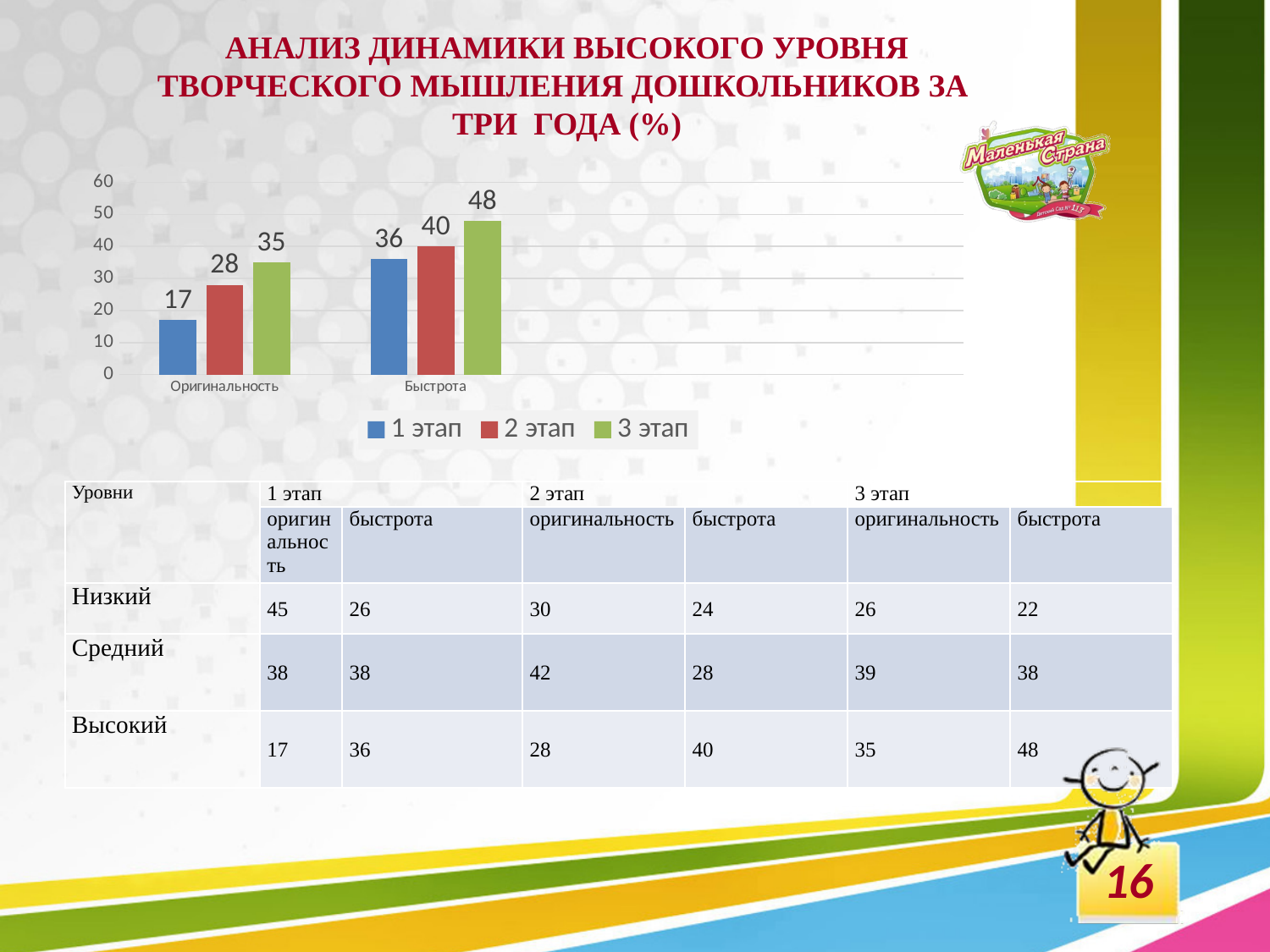
What colour are the bars for 3 этап? green What kind of chart is shown on the slide? bar chart Do the values for Быстрота rise or fall from 1 этап to 3 этап? rise How many categories are shown on the x axis? 2 How many series does the legend list? 3 What is the difference between the 3 этап and 1 этап values for Оригинальность? 18 Which series has the lowest value in the Оригинальность category? 1 этап Which is larger: the 2 этап value for Быстрота or the 3 этап value for Оригинальность? 2 этап value for Быстрота What is the value for 3 этап in the Быстрота category? 48 What is the value for 2 этап in the Оригинальность category? 28 What is the value for 1 этап in the Оригинальность category? 17 Which series has the highest value in the Быстрота category? 3 этап